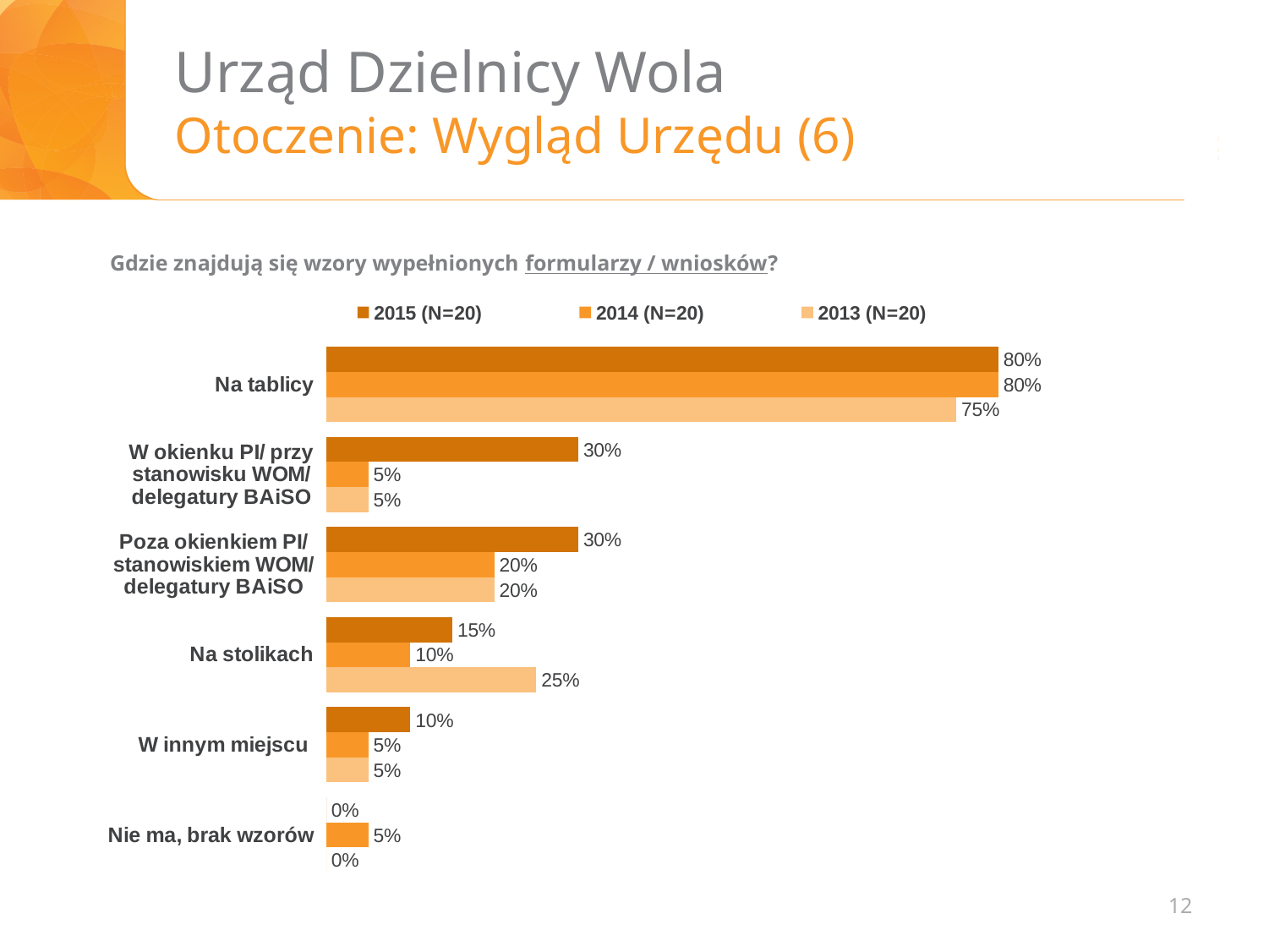
How many categories are shown on the chart? 6 What is the difference between the 2015 (N=20) and 2014 (N=20) values for "W okienku PI/ przy stanowisku WOM/ delegatury BAiSO"? 25% What kind of chart is shown on the slide? Bar chart What is the value for "Na stolikach" in the 2013 (N=20) series? 25% Which category has the lowest value in the 2015 (N=20) series? Nie ma, brak wzorów What question does the chart answer, as stated above it? Gdzie znajdują się wzory wypełnionych formularzy / wniosków? For "Na stolikach", which series has the larger value: 2015 (N=20) or 2013 (N=20)? 2013 (N=20) Which category has the highest value in the 2013 (N=20) series? Na tablicy What is the value for "Na tablicy" in the 2015 (N=20) series? 80% What is the value for "W okienku PI/ przy stanowisku WOM/ delegatury BAiSO" in the 2015 (N=20) series? 30% How many series does the legend list? 3 What is the value for "Nie ma, brak wzorów" in the 2014 (N=20) series? 5%